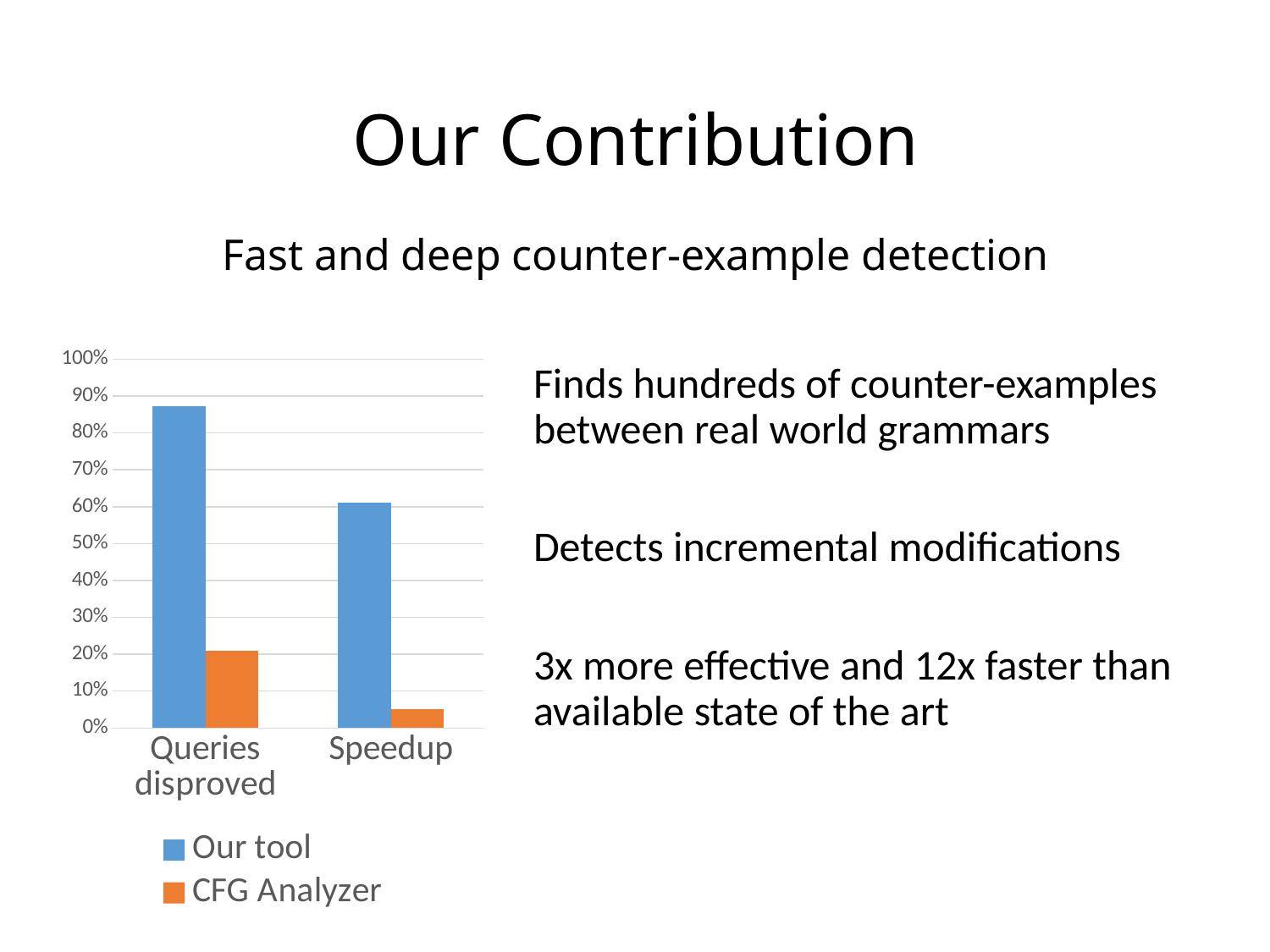
What kind of chart is shown on the slide? bar chart Is the value for CFG Analyzer in Speedup greater or less than 10%? less Which series has the larger value for Queries disproved, Our tool or CFG Analyzer? Our tool How many series does the chart legend list? 2 Which series is shown in orange in the chart? CFG Analyzer Which bar in the chart is the lowest? CFG Analyzer, Speedup How many categories are shown on the x axis of the chart? 2 Is the value for Our tool in Queries disproved greater or less than 80%? greater Is the value for CFG Analyzer in Queries disproved greater or less than 30%? less Which bar in the chart is the highest? Our tool, Queries disproved Which series is shown in blue in the chart? Our tool